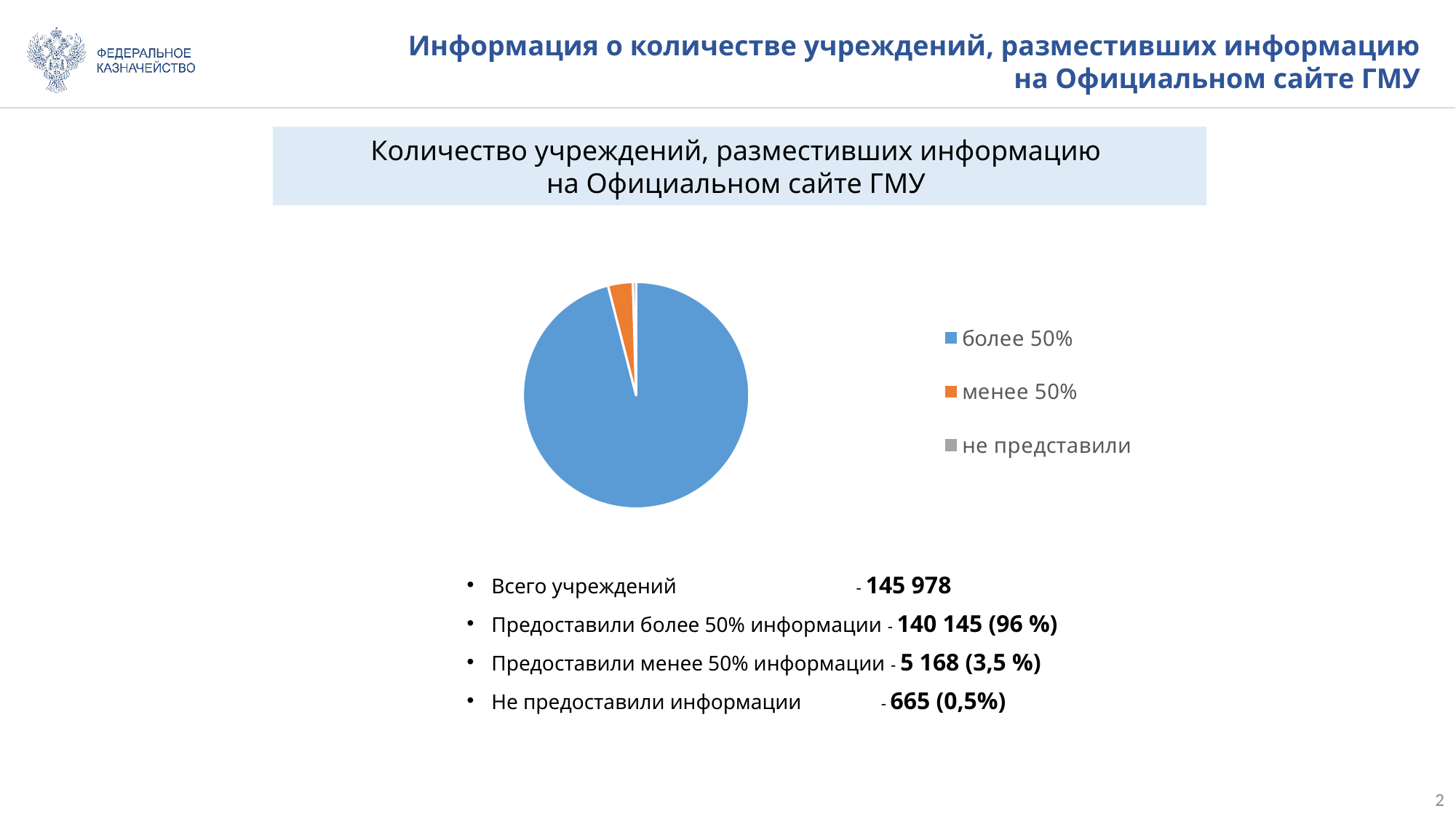
Which category has the largest slice in the pie chart? более 50% What share of the pie does the 'не представили' category represent, according to the slide? 0,5% How many slices does the pie chart have? 3 How many entries does the legend of the pie chart list? 3 Which category has the smallest slice in the pie chart? не представили What kind of chart is shown on the slide? pie chart Which slice is larger: 'менее 50%' or 'не представили'? менее 50% What is the total number of institutions given on the slide? 145 978 What colour is the 'менее 50%' slice in the pie chart? orange What share of the pie does the 'менее 50%' category represent, according to the slide? 3,5 % What share of the pie does the 'более 50%' category represent, according to the slide? 96 % How many institutions provided more than 50% of information, according to the slide? 140 145